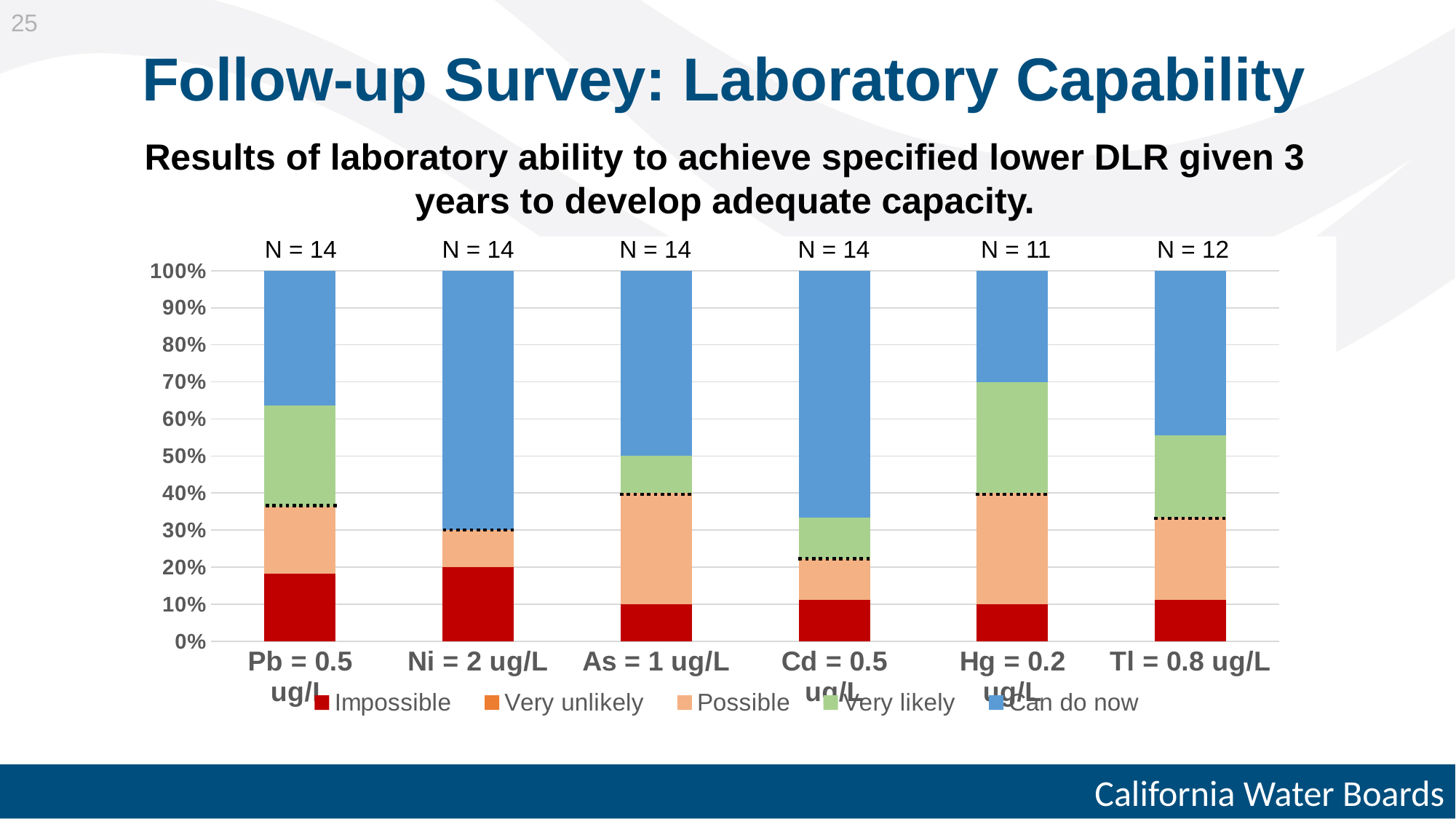
Is the 'Can do now' share for Hg = 0.2 ug/L greater or less than 40%? less How many series does the legend list? 5 What is the N value shown above the Pb = 0.5 ug/L bar? N = 14 Is the 'Very likely' share for Hg = 0.2 ug/L greater or less than 20%? greater What is the N value shown above the Hg = 0.2 ug/L bar? N = 11 Is the 'Can do now' share for Ni = 2 ug/L greater or less than 60%? greater What kind of chart is shown on the slide? Stacked bar chart Which category has the smallest 'Very likely' share? Ni = 2 ug/L How many contaminant categories are shown along the x axis? 6 Which legend entry is shown in blue? Can do now What is the N value shown above the Tl = 0.8 ug/L bar? N = 12